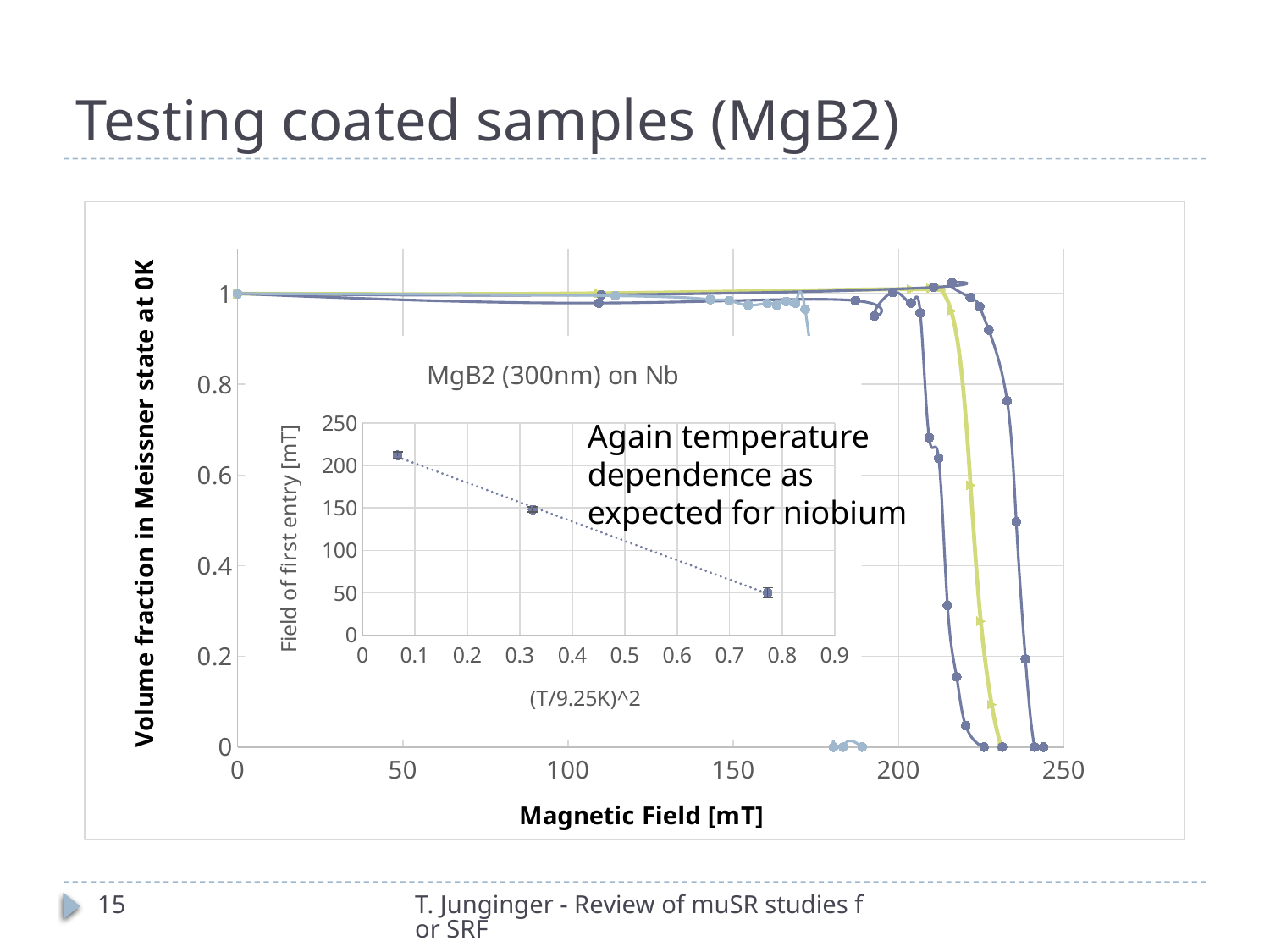
What is the highest tick value shown on the x-axis of the main chart? 250 In the main chart, is the volume fraction in Meissner state at a magnetic field of 150 mT greater or less than 0.6? greater In the inset chart titled MgB2 (300nm) on Nb, is the field of first entry for the rightmost point greater or less than 100 mT? less In the inset chart titled MgB2 (300nm) on Nb, which point has the higher field of first entry: the one at the smallest (T/9.25K)^2 or the one at the largest (T/9.25K)^2? the one at the smallest (T/9.25K)^2 What is the y-axis title of the main chart? Volume fraction in Meissner state at 0K What is the x-axis title of the main chart? Magnetic Field [mT] In the inset chart titled MgB2 (300nm) on Nb, is the field of first entry for the leftmost point greater or less than 200 mT? greater In the main chart, do the curves rise or fall as the magnetic field increases beyond 200 mT? fall What kind of chart is the main chart on the slide? line chart How many data points are plotted in the inset chart titled MgB2 (300nm) on Nb? 3 In the inset chart titled MgB2 (300nm) on Nb, does the field of first entry rise or fall as (T/9.25K)^2 increases? fall